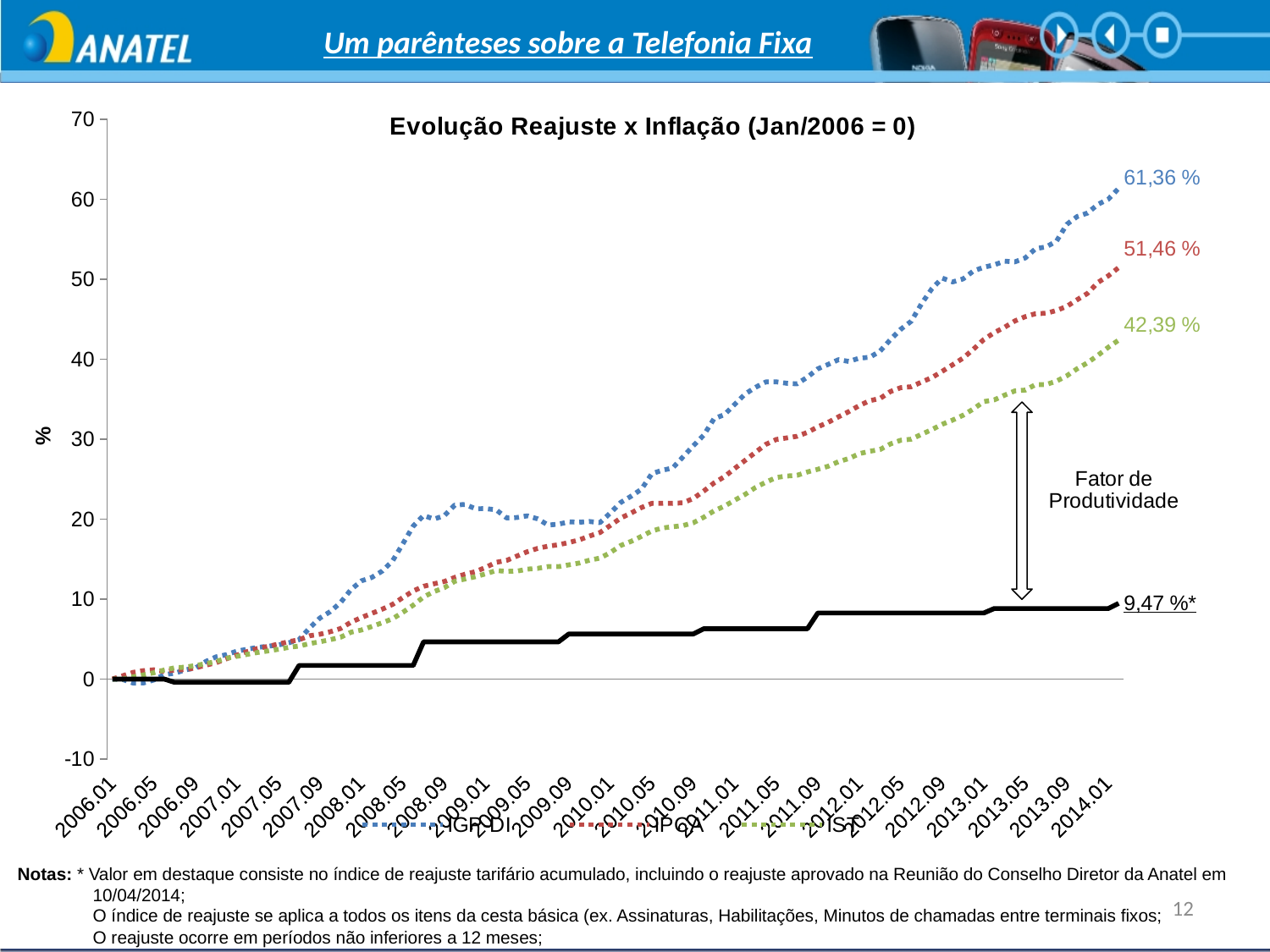
What is the title of the chart? Evolução Reajuste x Inflação (Jan/2006 = 0) What is the difference between the final values of the blue line (61,36 %) and the red line (51,46 %)? 9,90 % What text labels the double-headed arrow between the green line and the black line? Fator de Produtividade What value does the red dotted line (IPCA) reach at the end of the series? 51,46 % What value does the green dotted line (IST) reach at the end of the series? 42,39 % Is the value of the blue dotted line at 2012.09 greater or less than 40? greater Which line ends at the highest value? the blue dotted line (IGP-DI) What value does the blue dotted line (IGP-DI) reach at the end of the series? 61,36 % What kind of chart is shown on the slide? line chart Which line ends at the lowest value? the solid black line At the end of the series, which is larger: the red line (IPCA) or the green line (IST)? the red line (IPCA) What value is labelled at the end of the solid black line? 9,47 %*